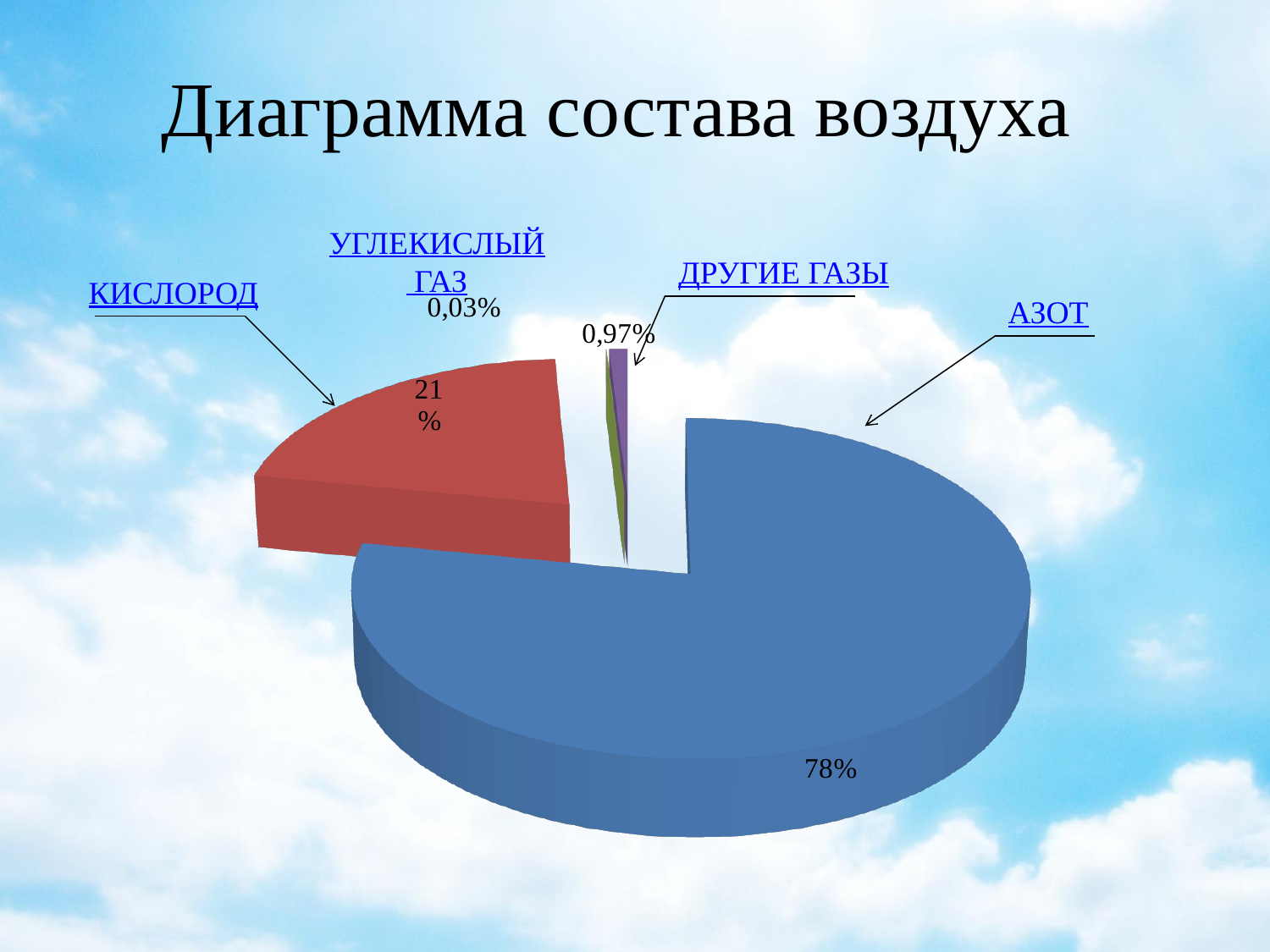
Which is larger, the share for КИСЛОРОД or the share for ДРУГИЕ ГАЗЫ? КИСЛОРОД How many slices does the pie chart have? 4 What kind of chart is shown on the slide? pie chart What share of the pie does ДРУГИЕ ГАЗЫ have? 0,97% By how many percentage points does the share of АЗОТ exceed the share of КИСЛОРОД? 57 What colour is the slice for АЗОТ? blue What share of the pie does АЗОТ have? 78% Which slice of the pie is the largest? АЗОТ Which slice of the pie is the smallest? УГЛЕКИСЛЫЙ ГАЗ What share of the pie does УГЛЕКИСЛЫЙ ГАЗ have? 0,03% What share of the pie does КИСЛОРОД have? 21% What is the title of the chart on the slide? Диаграмма состава воздуха